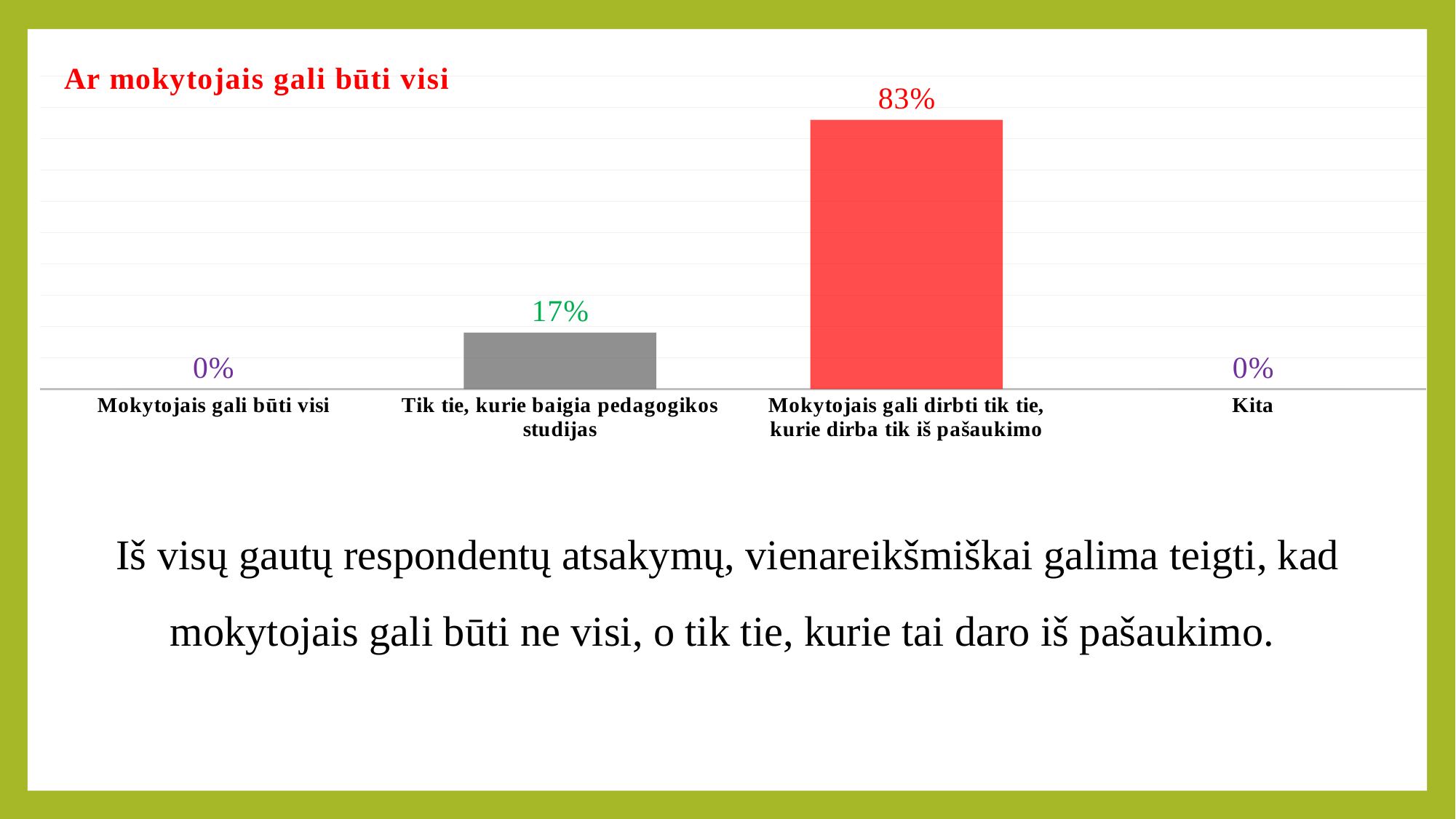
What is the value for "Tik tie, kurie baigia pedagogikos studijas"? 17% Which category has the highest value? Mokytojais gali dirbti tik tie, kurie dirba tik iš pašaukimo What kind of chart is shown on the slide? Bar chart Which is larger: the value for "Tik tie, kurie baigia pedagogikos studijas" or the value for "Kita"? Tik tie, kurie baigia pedagogikos studijas What is the value for "Mokytojais gali dirbti tik tie, kurie dirba tik iš pašaukimo"? 83% What is the value for "Kita"? 0% What is the title of the chart? Ar mokytojais gali būti visi How many categories are shown on the x axis? 4 How many categories have a value of 0%? 2 What colour is the bar for "Mokytojais gali dirbti tik tie, kurie dirba tik iš pašaukimo"? Red What is the value for "Mokytojais gali būti visi"? 0% What is the difference between the values for "Mokytojais gali dirbti tik tie, kurie dirba tik iš pašaukimo" and "Tik tie, kurie baigia pedagogikos studijas"? 66%